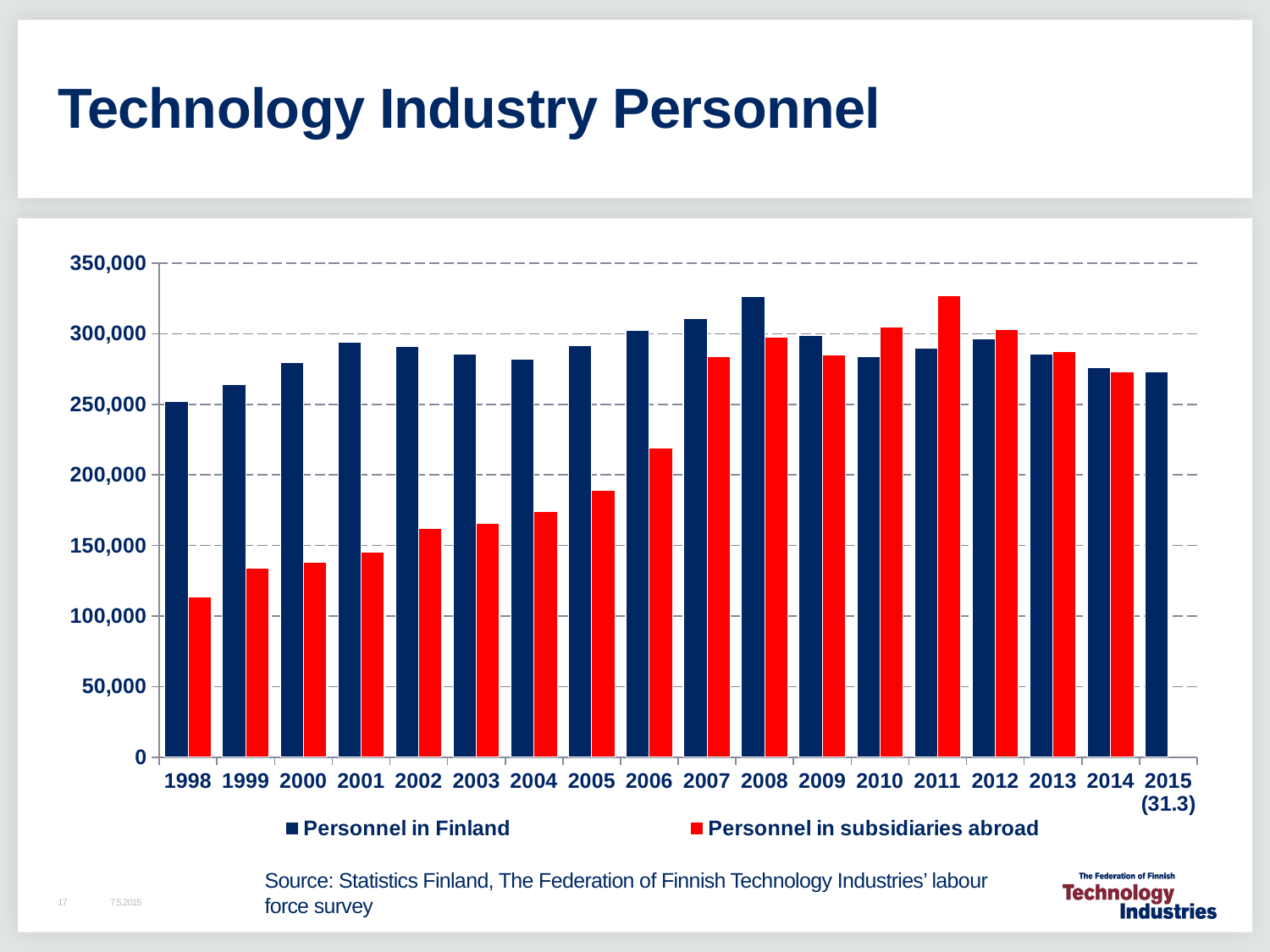
In which year is Personnel in subsidiaries abroad lowest? 1998 In which year is Personnel in Finland highest? 2008 In 2011, which is larger: Personnel in Finland or Personnel in subsidiaries abroad? Personnel in subsidiaries abroad What kind of chart is shown on the slide? bar chart In 2000, which is larger: Personnel in Finland or Personnel in subsidiaries abroad? Personnel in Finland Does Personnel in subsidiaries abroad rise or fall from 1998 to 2011? rise How many series does the legend list? 2 How many years are shown on the x axis? 18 Is the value for Personnel in Finland in 2008 greater or less than 300,000? greater Is the value for Personnel in subsidiaries abroad in 2006 greater or less than 200,000? greater In which year is Personnel in subsidiaries abroad highest? 2011 Is the value for Personnel in subsidiaries abroad in 1998 greater or less than 150,000? less